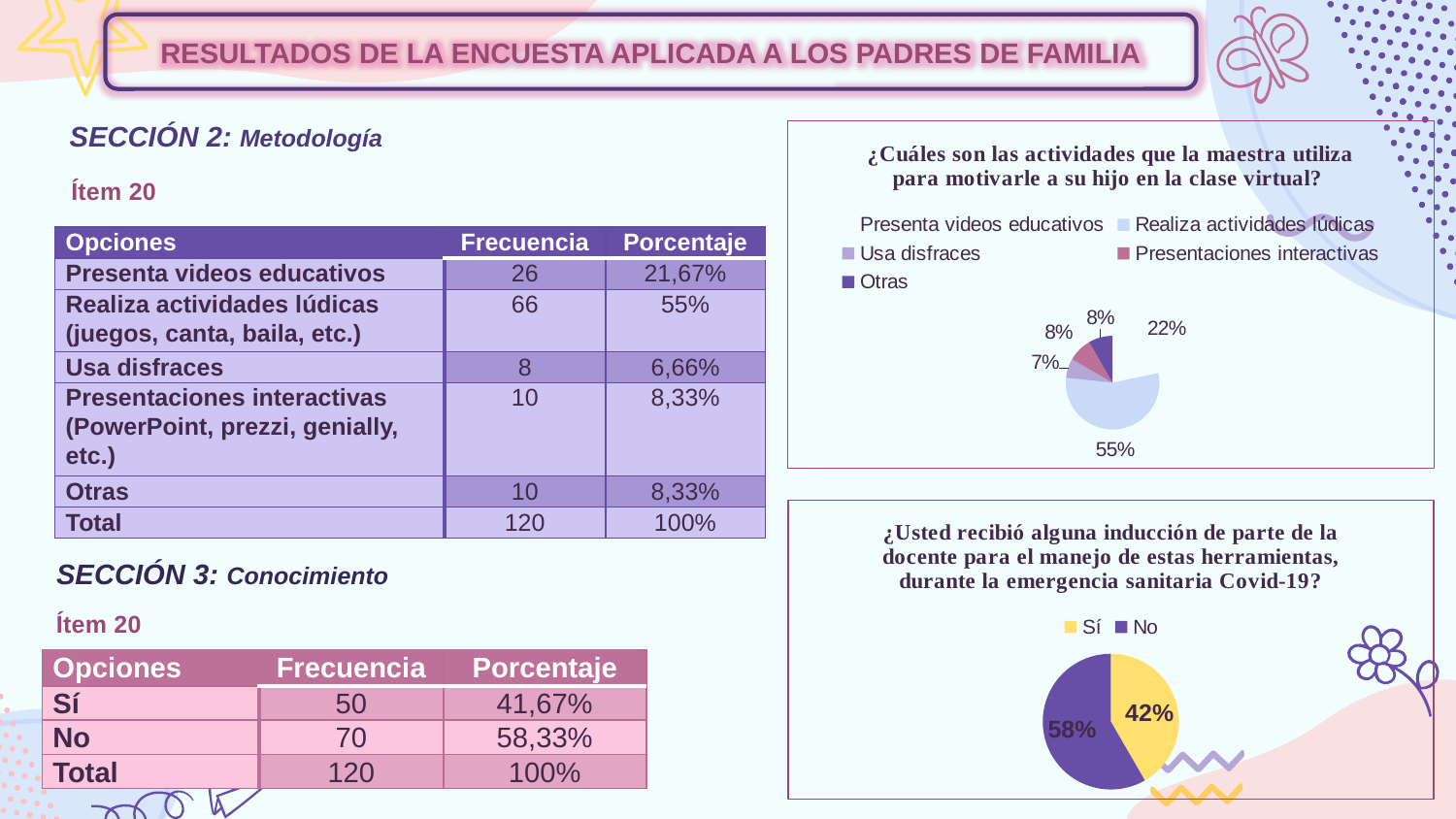
In the bottom pie chart, what percentage is shown for 'Sí'? 42% In the top pie chart, what percentage is shown for 'Usa disfraces'? 7% In the bottom pie chart, what colour is the 'Sí' slice? Yellow What type of chart is the bottom chart on the slide? Pie chart In the top pie chart, how many categories does the legend list? 5 In the top pie chart, which category has the largest slice? Realiza actividades lúdicas In the top pie chart, which category has the smallest slice? Usa disfraces In the top pie chart, what is the difference in percentage points between 'Realiza actividades lúdicas' and 'Presenta videos educativos'? 33 In the top pie chart, what percentage is shown for 'Presenta videos educativos'? 22% In the bottom pie chart, what percentage is shown for 'No'? 58% In the bottom pie chart, which is larger, 'Sí' or 'No'? No In the top pie chart, what percentage is shown for 'Realiza actividades lúdicas'? 55%